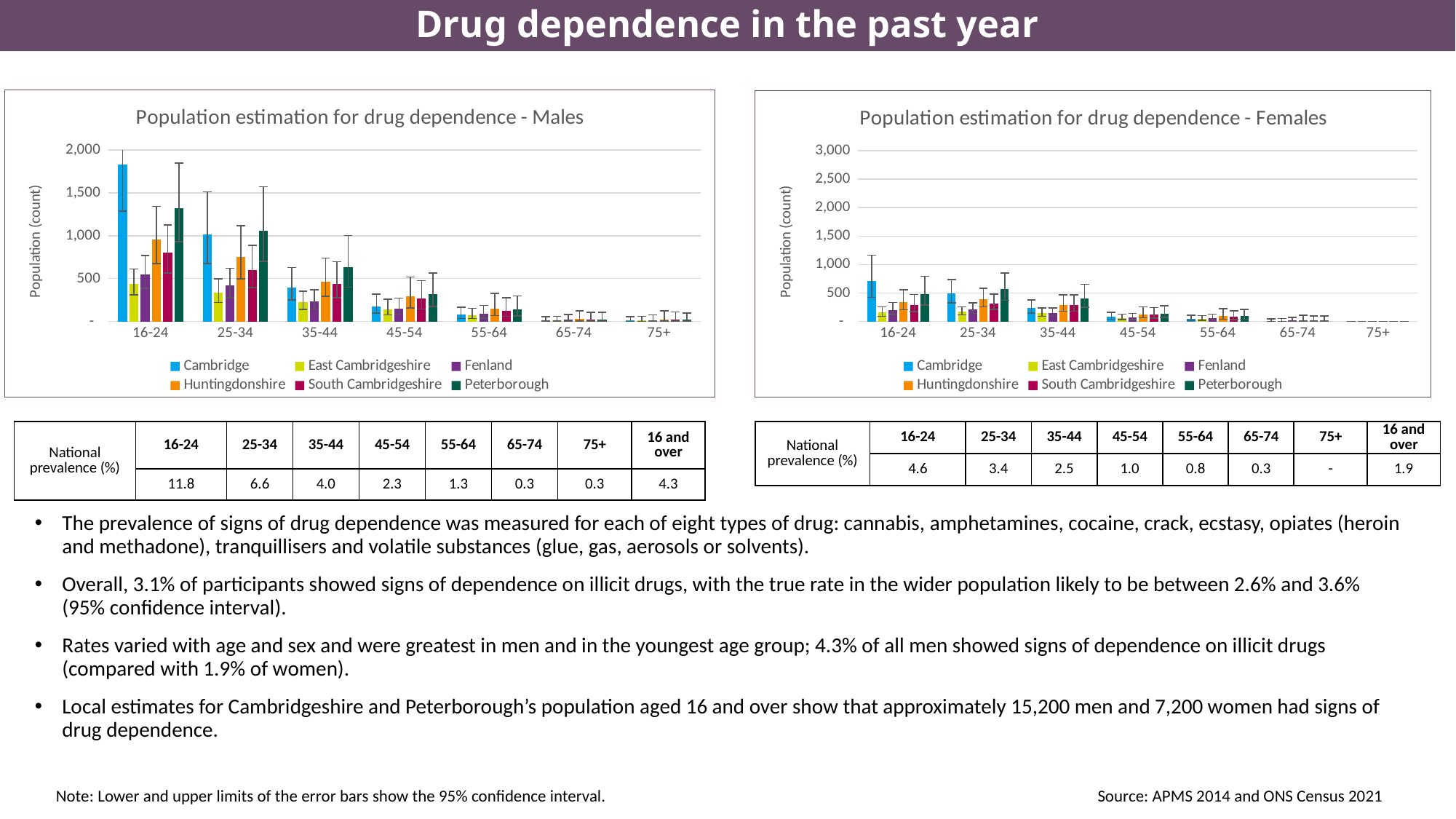
How many series does the legend of the 'Population estimation for drug dependence - Males' chart list? 6 In the 'Population estimation for drug dependence - Males' chart, which is larger in the 16-24 age group: Cambridge or Fenland? Cambridge What is the title of the chart on the right of the slide? Population estimation for drug dependence - Females In the 'Population estimation for drug dependence - Males' chart, is the value for Peterborough in the 16-24 age group greater or less than 1,000? greater In the 'Population estimation for drug dependence - Females' chart, which area has the highest bar in the 16-24 age group? Cambridge In the 'Population estimation for drug dependence - Males' chart, do the Cambridge values rise or fall as the age groups increase along the x axis? fall In the 'Population estimation for drug dependence - Males' chart, which area has the highest bar in the 16-24 age group? Cambridge In the 'Population estimation for drug dependence - Males' chart, is the value for East Cambridgeshire in the 16-24 age group greater or less than 500? less In the 'Population estimation for drug dependence - Females' chart, is the value for Cambridge in the 16-24 age group greater or less than 500? greater What kind of chart is the 'Population estimation for drug dependence - Males' chart? bar chart How many age groups are shown on the x axis of the 'Population estimation for drug dependence - Females' chart? 7